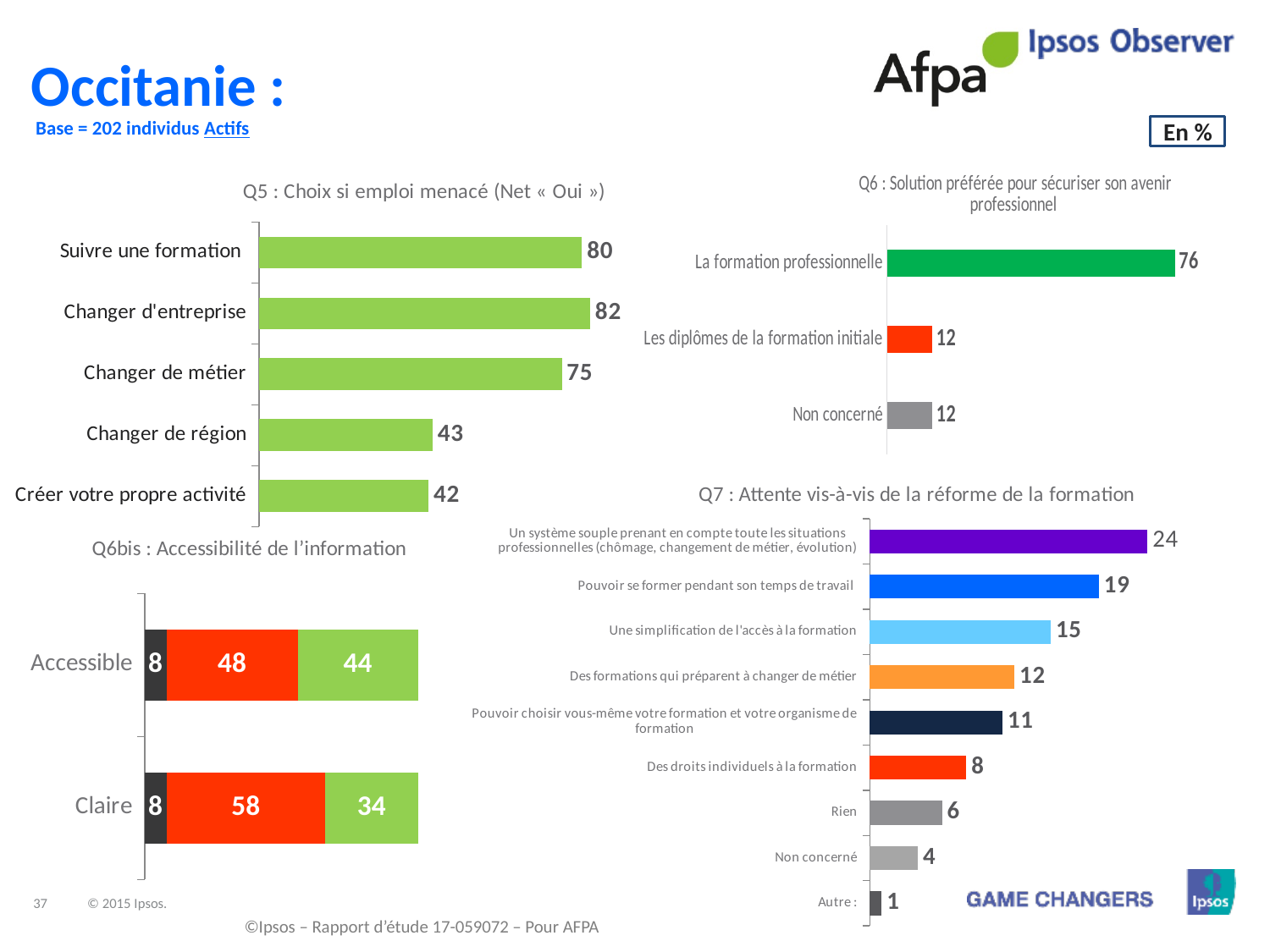
What type of chart is the Q6bis chart (Accessibilité de l'information)? Stacked bar chart In the Q5 chart (Choix si emploi menacé), how many categories are shown? 5 In the Q7 chart (Attente vis-à-vis de la réforme de la formation), how many categories are shown? 9 In the Q6 chart (Solution préférée pour sécuriser son avenir professionnel), which is larger: "La formation professionnelle" or "Les diplômes de la formation initiale"? La formation professionnelle In the Q5 chart (Choix si emploi menacé), which category has the highest value? Changer d'entreprise In the Q5 chart (Choix si emploi menacé), what is the difference between "Suivre une formation" and "Changer de région"? 37 In the Q6bis chart (Accessibilité de l'information), what is the total of the stacked bar for "Accessible"? 100 In the Q6 chart (Solution préférée pour sécuriser son avenir professionnel), what is the value for "La formation professionnelle"? 76 In the Q7 chart (Attente vis-à-vis de la réforme de la formation), which category has the lowest value? Autre : In the Q6bis chart (Accessibilité de l'information), what is the value of the middle (red) segment for "Claire"? 58 In the Q5 chart (Choix si emploi menacé), what is the value for "Changer de métier"? 75 In the Q7 chart (Attente vis-à-vis de la réforme de la formation), what is the value for "Pouvoir se former pendant son temps de travail"? 19